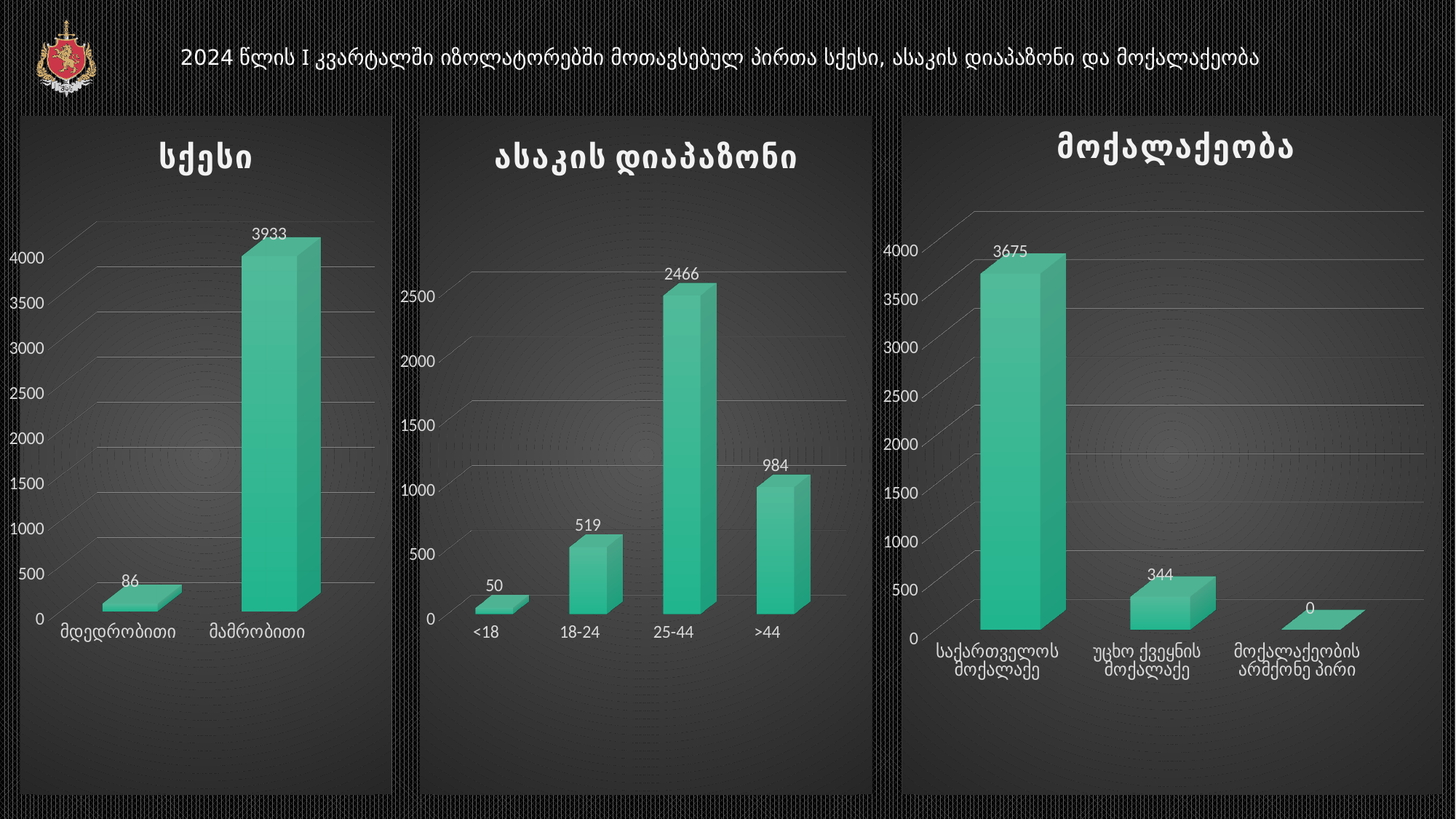
In the middle chart titled "ასაკის დიაპაზონი", which is larger, the value for 18-24 or the value for >44? >44 In the left chart titled "სქესი", what is the value for მდედრობითი? 86 In the middle chart titled "ასაკის დიაპაზონი", what is the value for the 25-44 category? 2466 What type of chart is the right chart titled "მოქალაქეობა"? Bar chart In the middle chart titled "ასაკის დიაპაზონი", how many age categories are shown? 4 In the right chart titled "მოქალაქეობა", what is the value for უცხო ქვეყნის მოქალაქე? 344 In the left chart titled "სქესი", what is the value for მამრობითი? 3933 In the right chart titled "მოქალაქეობა", what is the difference between the values for საქართველოს მოქალაქე and უცხო ქვეყნის მოქალაქე? 3331 In the middle chart titled "ასაკის დიაპაზონი", which age category has the highest value? 25-44 In the right chart titled "მოქალაქეობა", what is the value for მოქალაქეობის არმქონე პირი? 0 In the left chart titled "სქესი", what is the difference between the values for მამრობითი and მდედრობითი? 3847 In the middle chart titled "ასაკის დიაპაზონი", which age category has the lowest value? <18